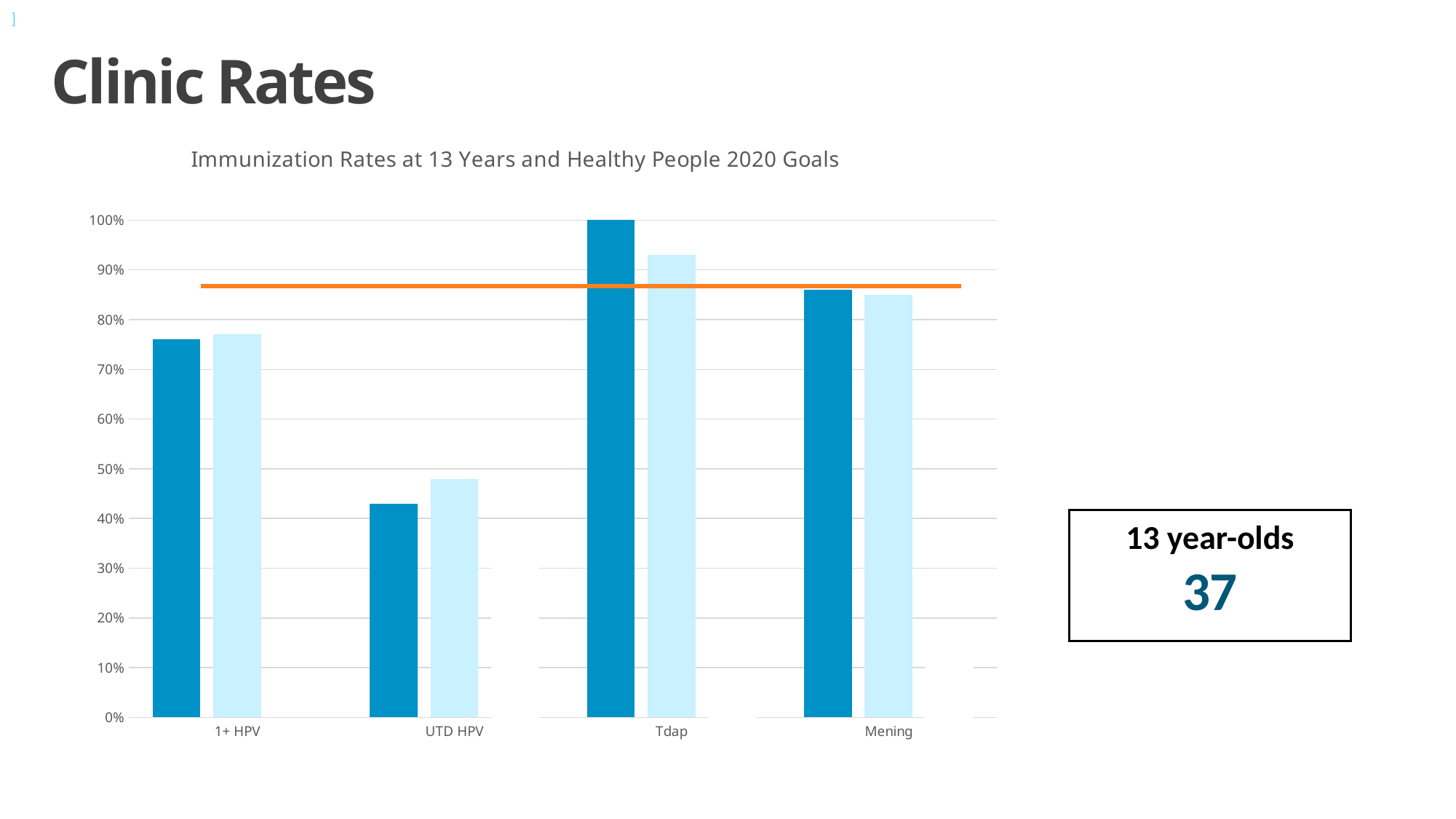
Is the light blue bar for Tdap greater or less than 90%? greater Which category has the highest dark blue bar? Tdap What is the title of the chart? Immunization Rates at 13 Years and Healthy People 2020 Goals Is the dark blue bar for UTD HPV greater or less than 50%? less Is the dark blue bar for Mening greater or less than 80%? greater What colour is the horizontal line drawn across the chart? orange What value does the dark blue bar for Tdap reach? 100% Which category has the lowest dark blue bar? UTD HPV What kind of chart is shown on the slide? bar chart Which has the larger dark blue bar, 1+ HPV or UTD HPV? 1+ HPV How many categories are shown on the x axis of the chart? 4